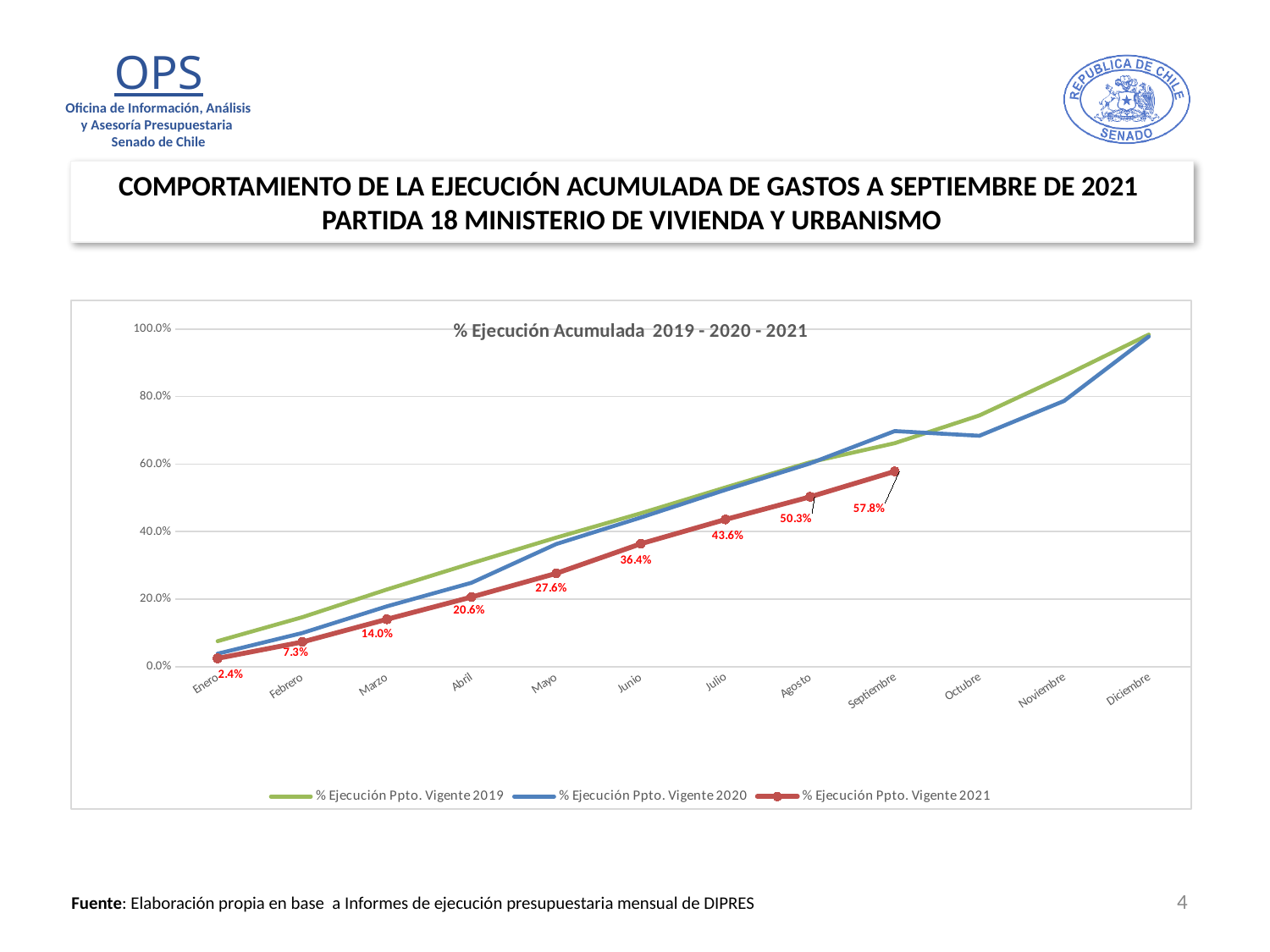
What is the difference between the 2021 values for Septiembre and Agosto? 7.5% How many months are shown on the x axis? 12 In which month does the % Ejecución Ppto. Vigente 2021 series reach its highest value? Septiembre What is the value of % Ejecución Ppto. Vigente 2021 in Enero? 2.4% Which is larger for the 2021 series: the value in Julio or the value in Mayo? Julio What is the value of % Ejecución Ppto. Vigente 2021 in Abril? 20.6% What is the value of % Ejecución Ppto. Vigente 2021 in Septiembre? 57.8% What type of chart is shown on the slide? Line chart How many series does the legend list? 3 Is the value of % Ejecución Ppto. Vigente 2019 in Diciembre greater or less than 80.0%? greater Does the % Ejecución Ppto. Vigente 2021 series rise or fall from Enero to Septiembre? Rises What is the title of the chart? % Ejecución Acumulada 2019 - 2020 - 2021